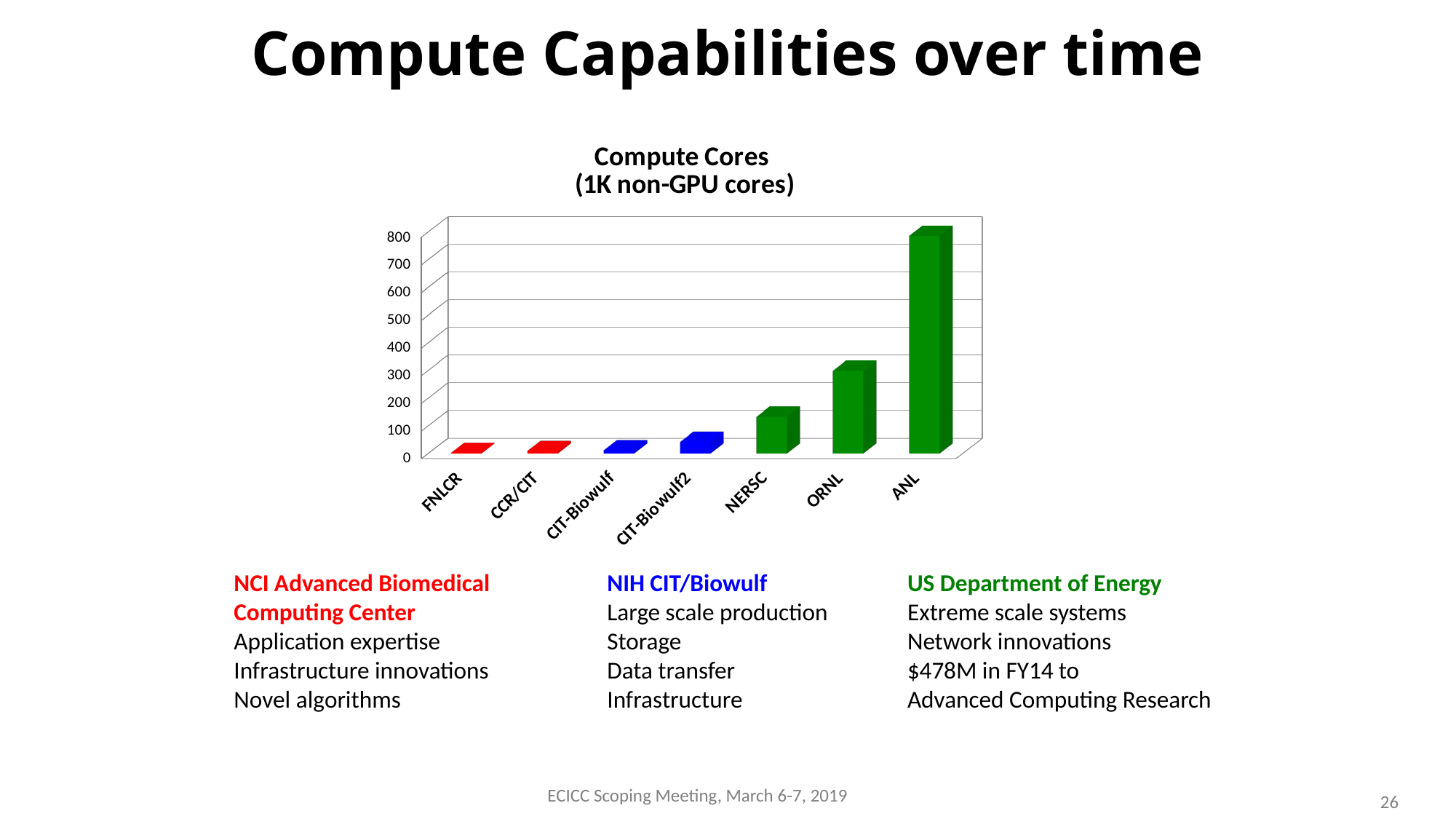
Is the value for ANL greater or less than 700? greater Is the value for ORNL greater or less than 400? less Is the value for NERSC greater or less than 200? less Which category has the lowest number of compute cores? FNLCR How many categories are shown on the x axis of the chart? 7 Which category has the highest number of compute cores? ANL Do the values generally rise or fall moving from left to right along the x axis? rise What is the title of the chart? Compute Cores (1K non-GPU cores) Which has more compute cores, ORNL or NERSC? ORNL What kind of chart is shown on the slide? bar chart